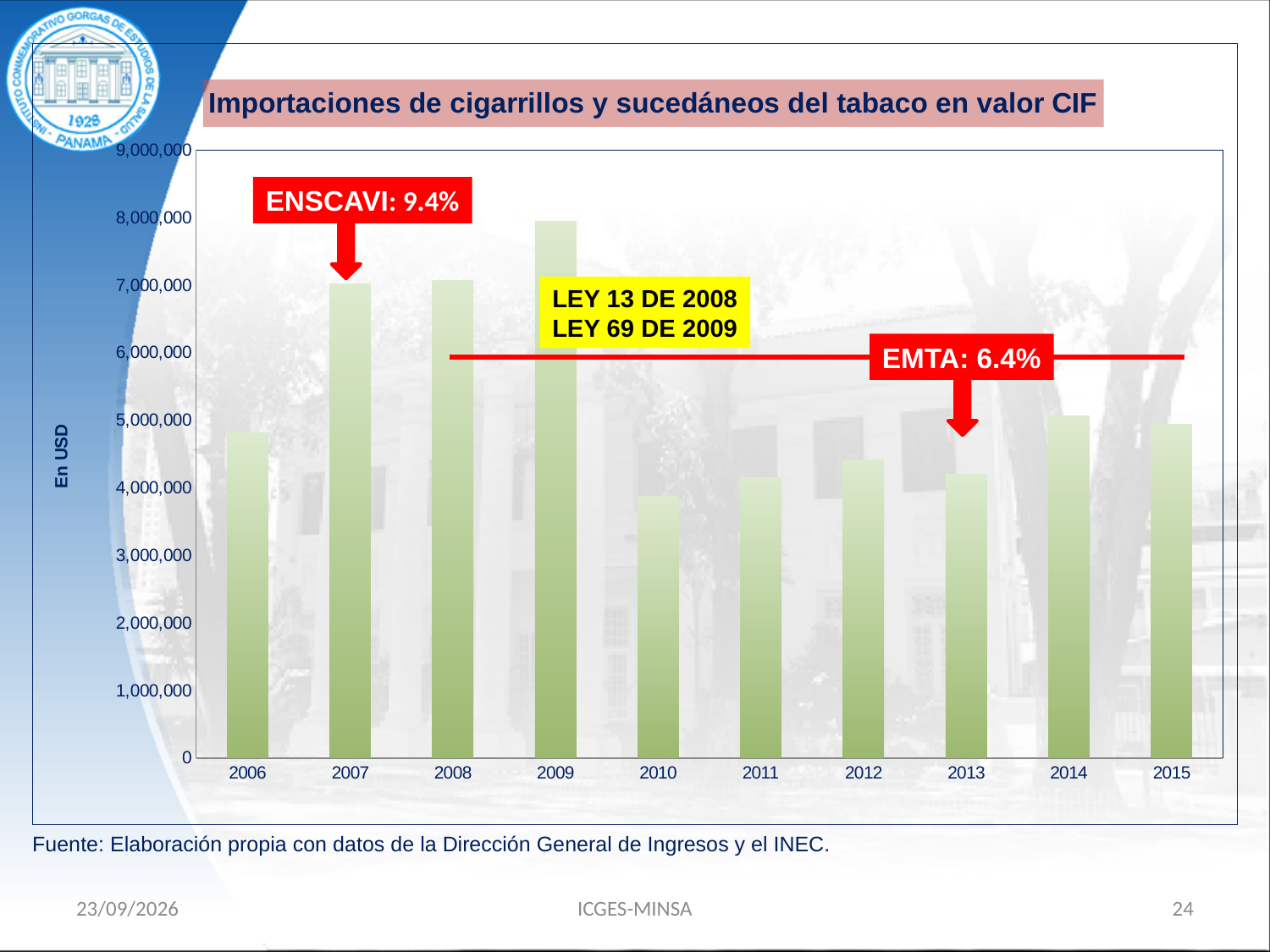
What is the label on the y axis of the chart? En USD Is the value for 2006 greater or less than 5,000,000? less Is the value for 2012 greater or less than 4,000,000? greater What kind of chart is shown on the slide? bar chart How many years are shown on the x axis of the chart? 10 Is the value for 2009 greater or less than 7,000,000? greater Do the values rise or fall from 2009 to 2010? fall Which year has the larger import value, 2012 or 2010? 2012 Which year has the lowest import value in the chart? 2010 Which year has the highest import value in the chart? 2009 Which year has the larger import value, 2009 or 2006? 2009